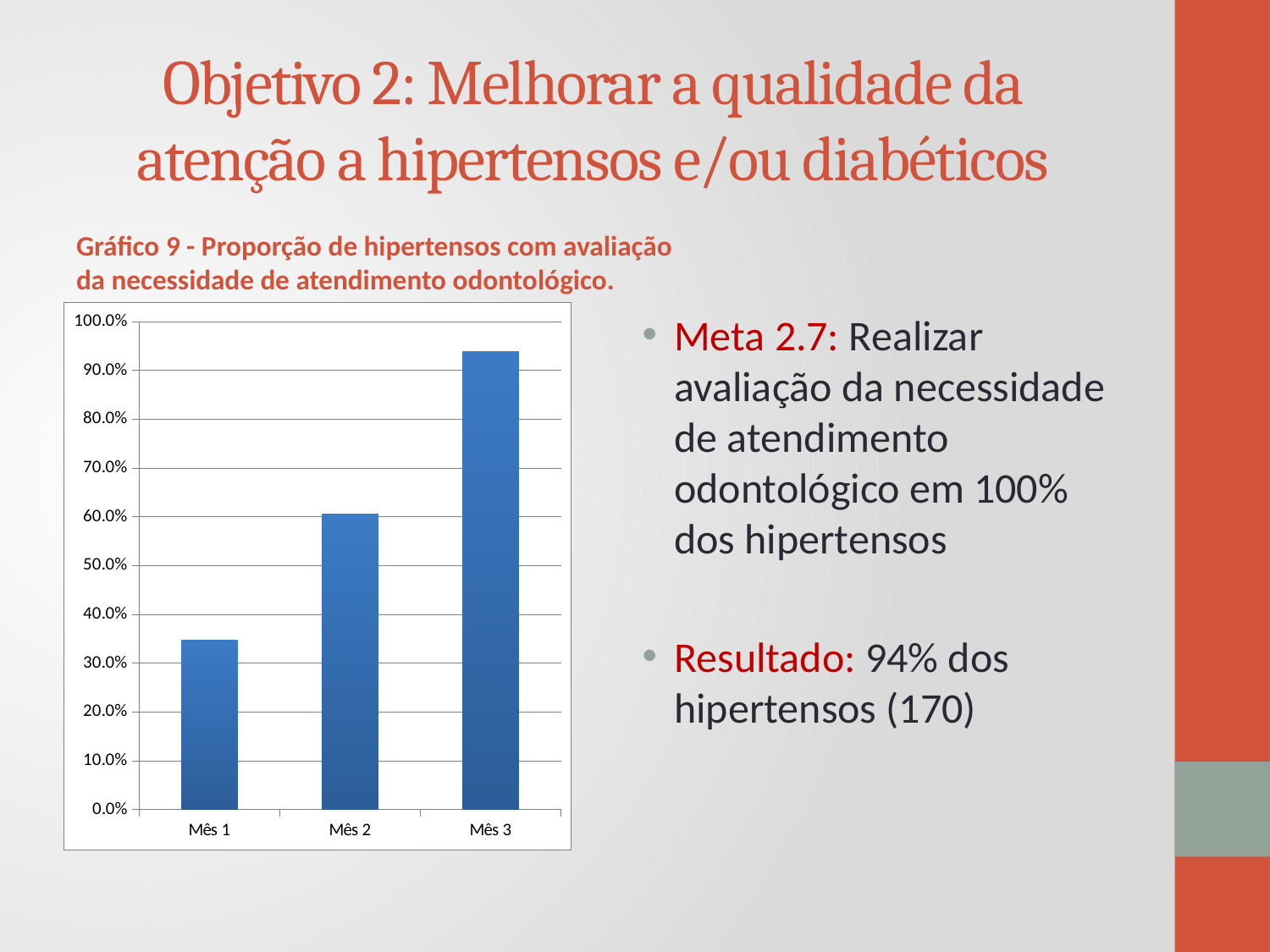
Which month has the highest value on the chart? Mês 3 Is the value for Mês 2 greater or less than 70.0%? less Is the value for Mês 2 greater or less than 50.0%? greater Which is larger, the value for Mês 1 or the value for Mês 2? Mês 2 Is the value for Mês 1 greater or less than 30.0%? greater What is the title of the chart (Gráfico 9)? Proporção de hipertensos com avaliação da necessidade de atendimento odontológico. How many categories (months) are plotted on the chart? 3 What kind of chart is shown on the slide? bar chart Which month has the lowest value on the chart? Mês 1 Do the values rise or fall from Mês 1 to Mês 3? rise